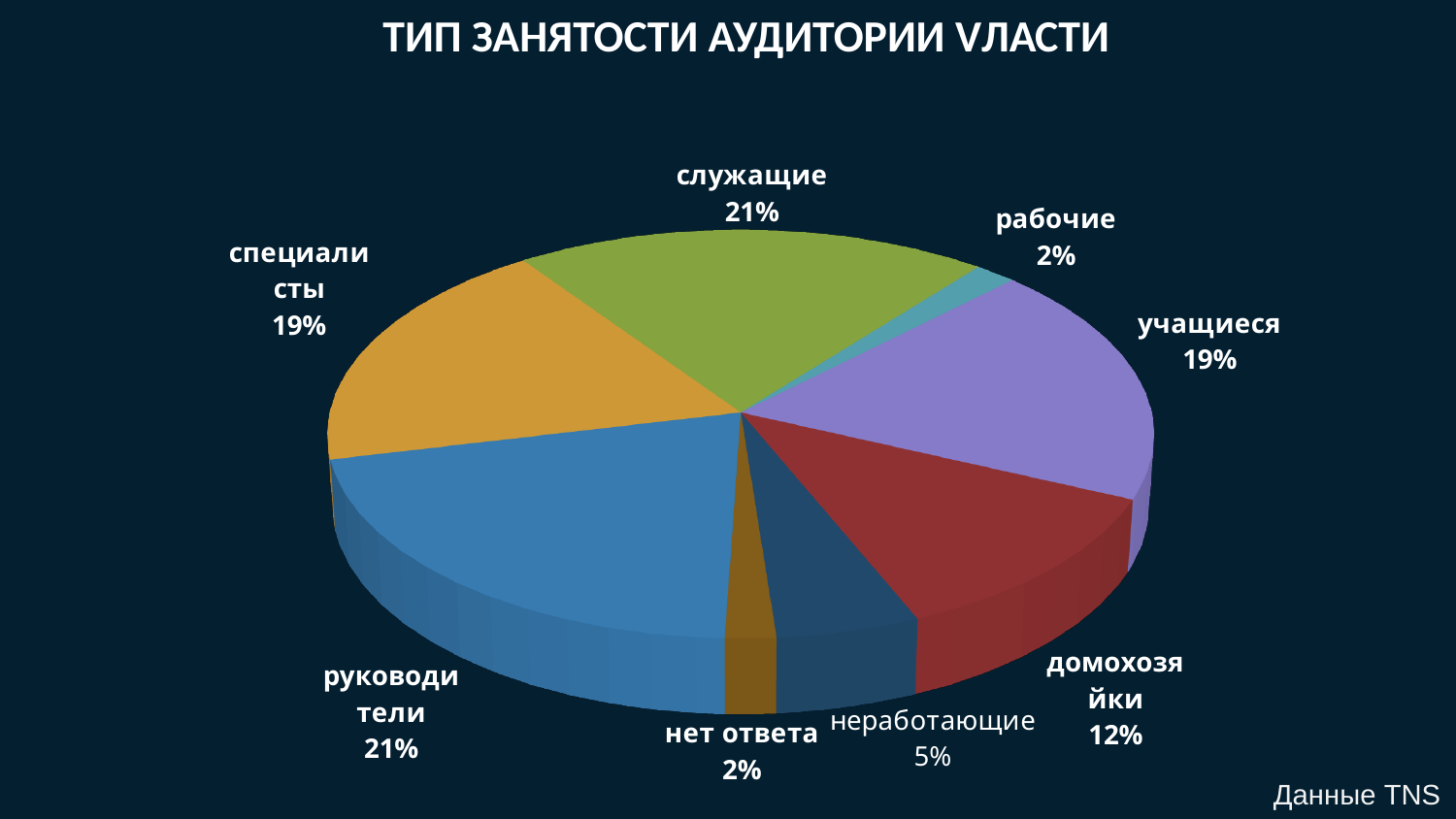
What kind of chart is shown on the slide? pie chart How many slices does the pie chart have? 8 What share of the audience is 'неработающие'? 5% What share of the audience is 'служащие'? 21% What data source is cited on the slide? Данные TNS What share of the audience is 'домохозяйки'? 12% What is the difference between the share for 'служащие' and the share for 'домохозяйки'? 9% What share of the audience is 'рабочие'? 2% Which is larger, the share for 'учащиеся' or the share for 'домохозяйки'? учащиеся What is the title of the chart? ТИП ЗАНЯТОСТИ АУДИТОРИИ VЛАСТИ What is the difference between the share for 'специалисты' and the share for 'неработающие'? 14% What share of the audience is 'учащиеся'? 19%